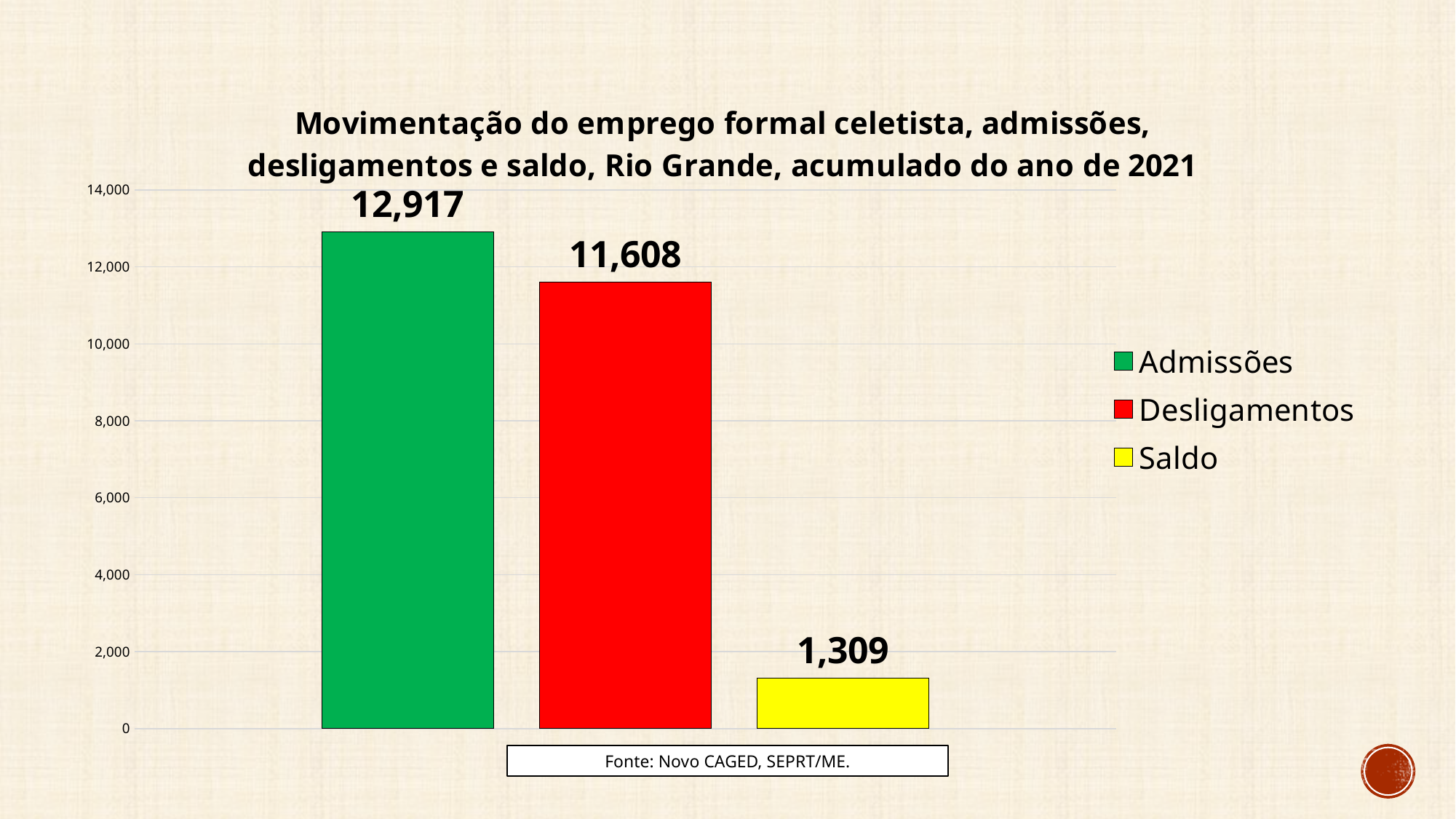
How many series does the legend list? 3 What is the value for Desligamentos? 11,608 Which series has the lowest value? Saldo Which is larger, Desligamentos or Saldo? Desligamentos What colour is the bar for Saldo? yellow What is the difference between Admissões and Desligamentos? 1,309 How many bars are plotted in the chart? 3 What is the value for Saldo? 1,309 What kind of chart is shown on the slide? bar chart Is the value for Desligamentos greater or less than 12,000? less What is the value for Admissões? 12,917 Which series has the highest value? Admissões